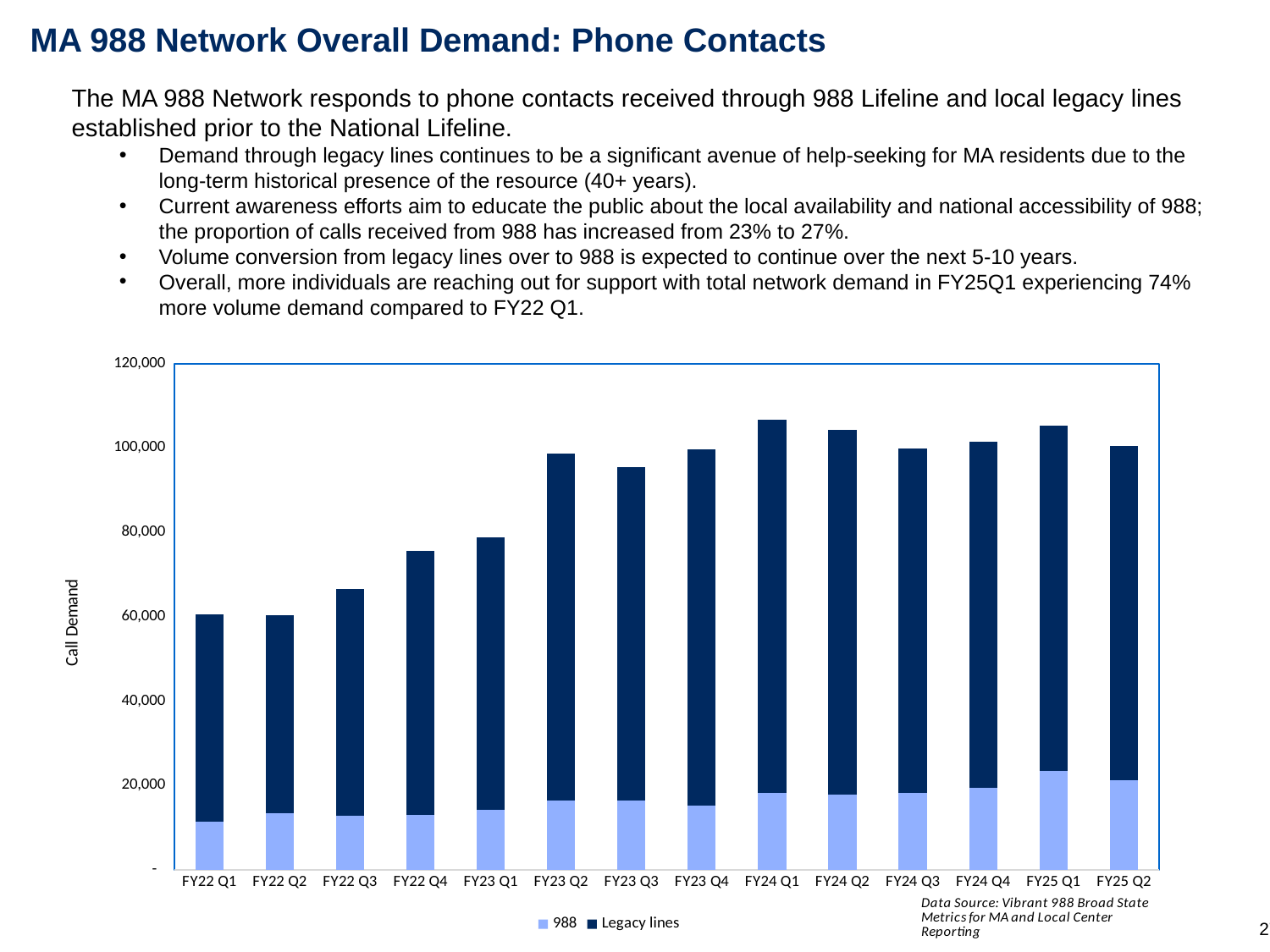
What are the two series named in the chart's legend? 988 and Legacy lines Is the total call demand for FY24 Q1 greater or less than 100,000? greater Is the total call demand for FY22 Q3 greater or less than 60,000? greater Is the total call demand for FY23 Q3 greater or less than 100,000? less Which is larger, the total call demand for FY22 Q3 or for FY23 Q2? FY23 Q2 How many quarters (categories) are shown on the x axis of the chart? 14 What kind of chart is shown on the slide? Stacked bar chart What is the label on the vertical axis of the chart? Call Demand How many series does the chart's legend list? 2 Overall, does total call demand rise or fall from FY22 Q1 to FY25 Q2? rise